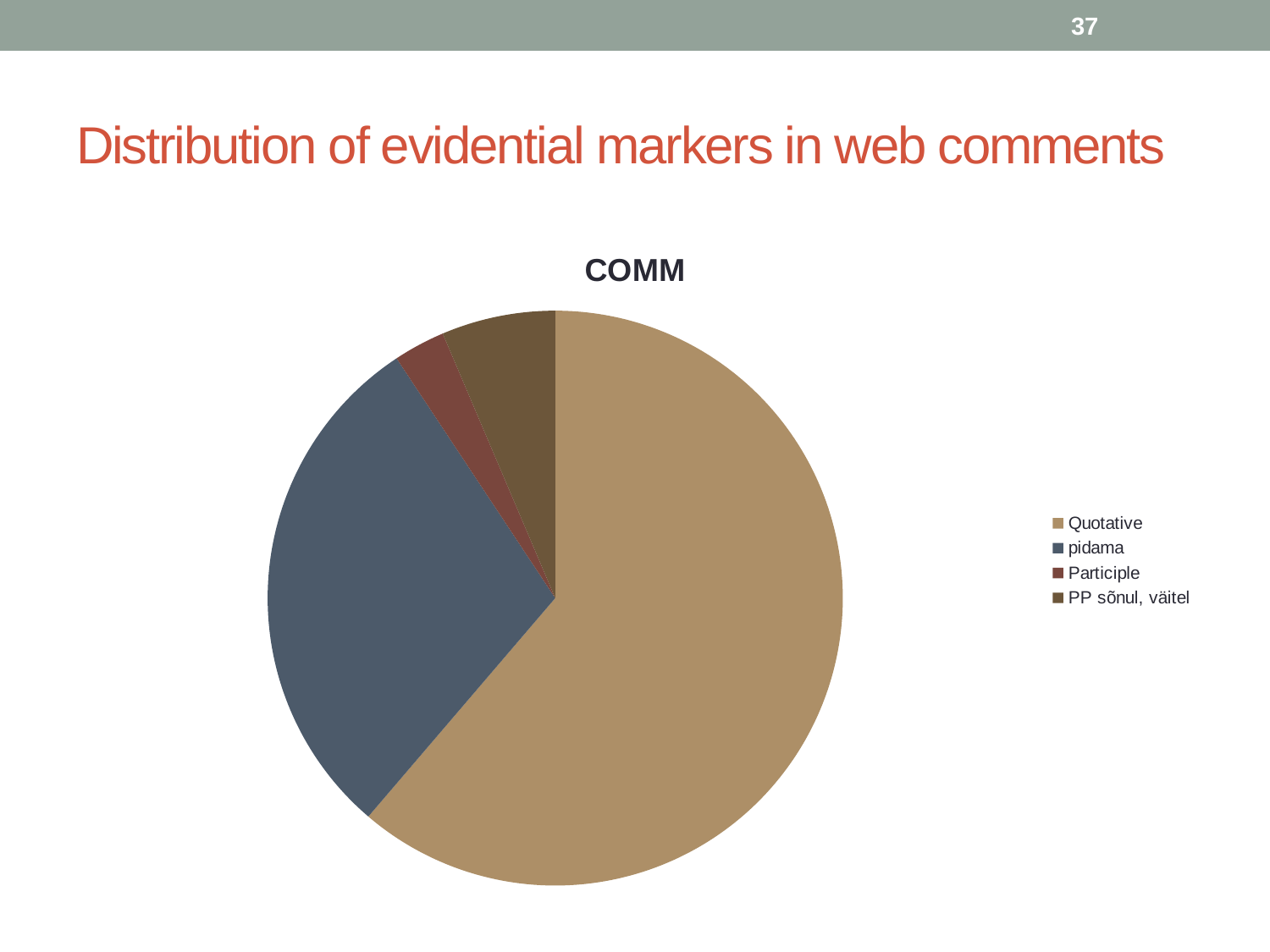
What is the title of the chart? COMM Which category has the largest slice of the pie? Quotative Which category has the smallest slice of the pie? Participle Which slice is larger, pidama or Participle? pidama How many categories does the legend of the pie chart list? 4 Which slice is larger, Quotative or pidama? Quotative Which category has the second-largest slice of the pie? pidama Which category is shown in the tan/gold colour in the pie chart? Quotative What kind of chart is shown on the slide? pie chart How many slices does the pie chart have? 4 Which slice is larger, PP sõnul, väitel or Participle? PP sõnul, väitel